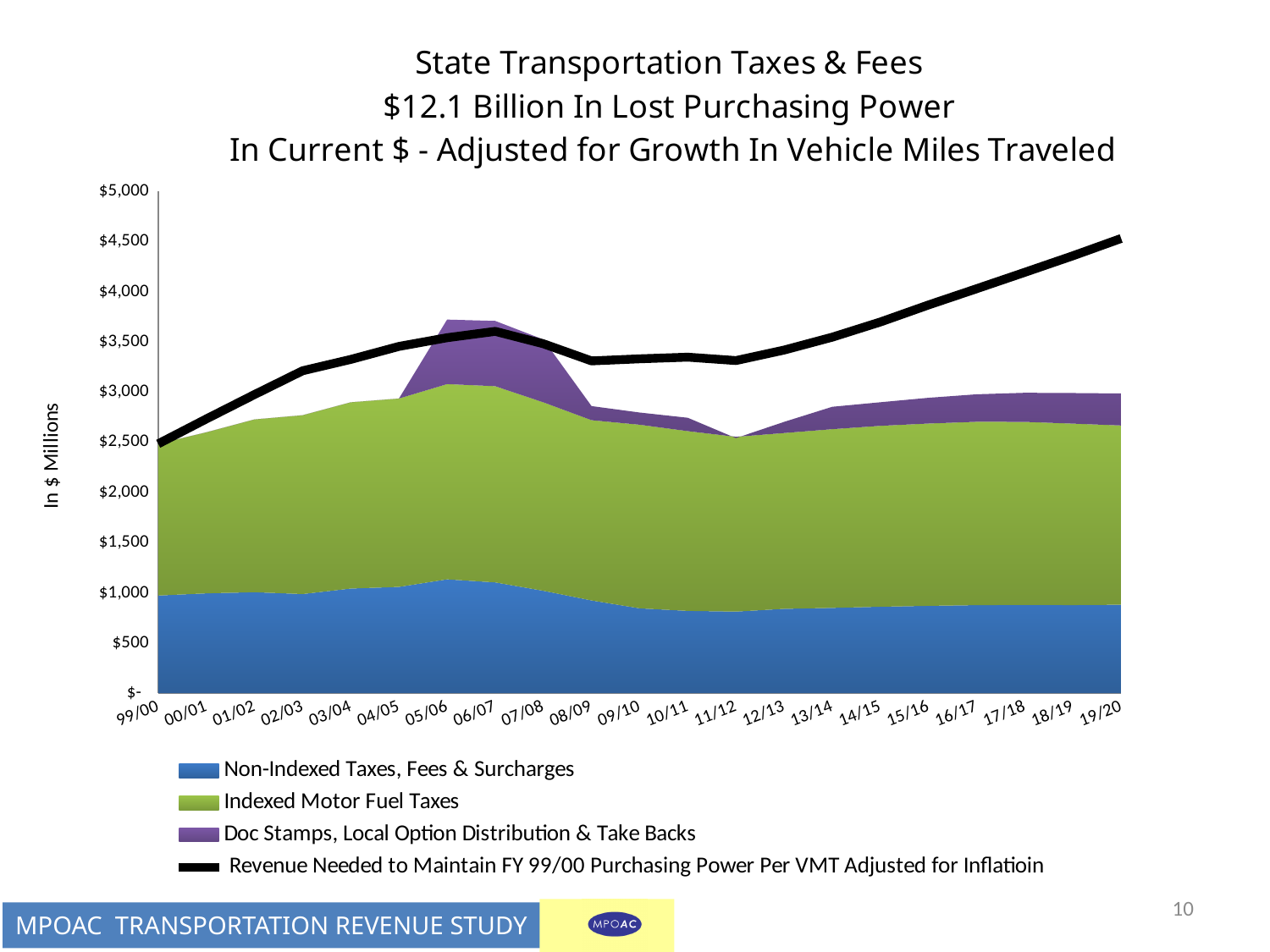
Is the value of Non-Indexed Taxes, Fees & Surcharges in 09/10 greater or less than $1,000? less How many series does the legend list? 4 In which fiscal year does the Revenue Needed line reach its highest value? 19/20 Does the Revenue Needed line rise or fall overall from 99/00 to 19/20? rise Is the value of the Revenue Needed line in 09/10 greater or less than $3,000? greater What kind of chart is shown on the slide? Stacked area chart with a line Is the value of the Revenue Needed line in 18/19 greater or less than $4,000? greater Which series is drawn as the black line? Revenue Needed to Maintain FY 99/00 Purchasing Power Per VMT Adjusted for Inflatioin How many fiscal years are shown along the x axis? 21 What is the label on the vertical axis? In $ Millions